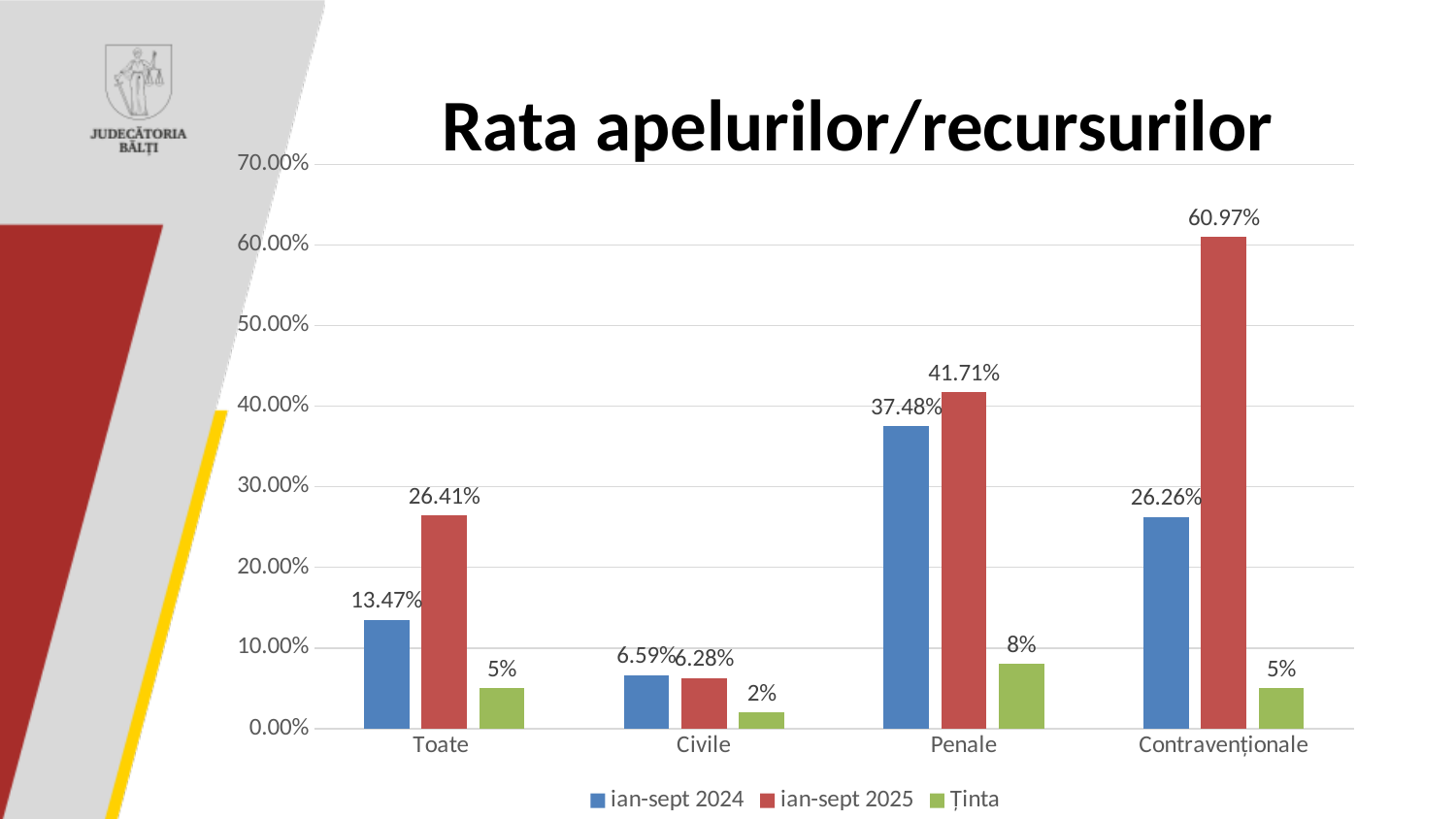
What kind of chart is shown on the slide? bar chart What is the value for ian-sept 2024 in the Penale category? 37.48% What is the difference between the ian-sept 2025 and ian-sept 2024 values for Toate? 12.94% Is the ian-sept 2025 value for Penale greater or less than 40.00%? greater Which category has the highest ian-sept 2025 value? Contravenționale Which category has the lowest ian-sept 2024 value? Civile How many series does the legend list? 3 How many categories are shown on the x axis? 4 What is the Ținta value for the Civile category? 2% Which is larger for Contravenționale: the ian-sept 2024 value or the ian-sept 2025 value? ian-sept 2025 What is the value for ian-sept 2025 in the Contravenționale category? 60.97% What is the title of the chart? Rata apelurilor/recursurilor